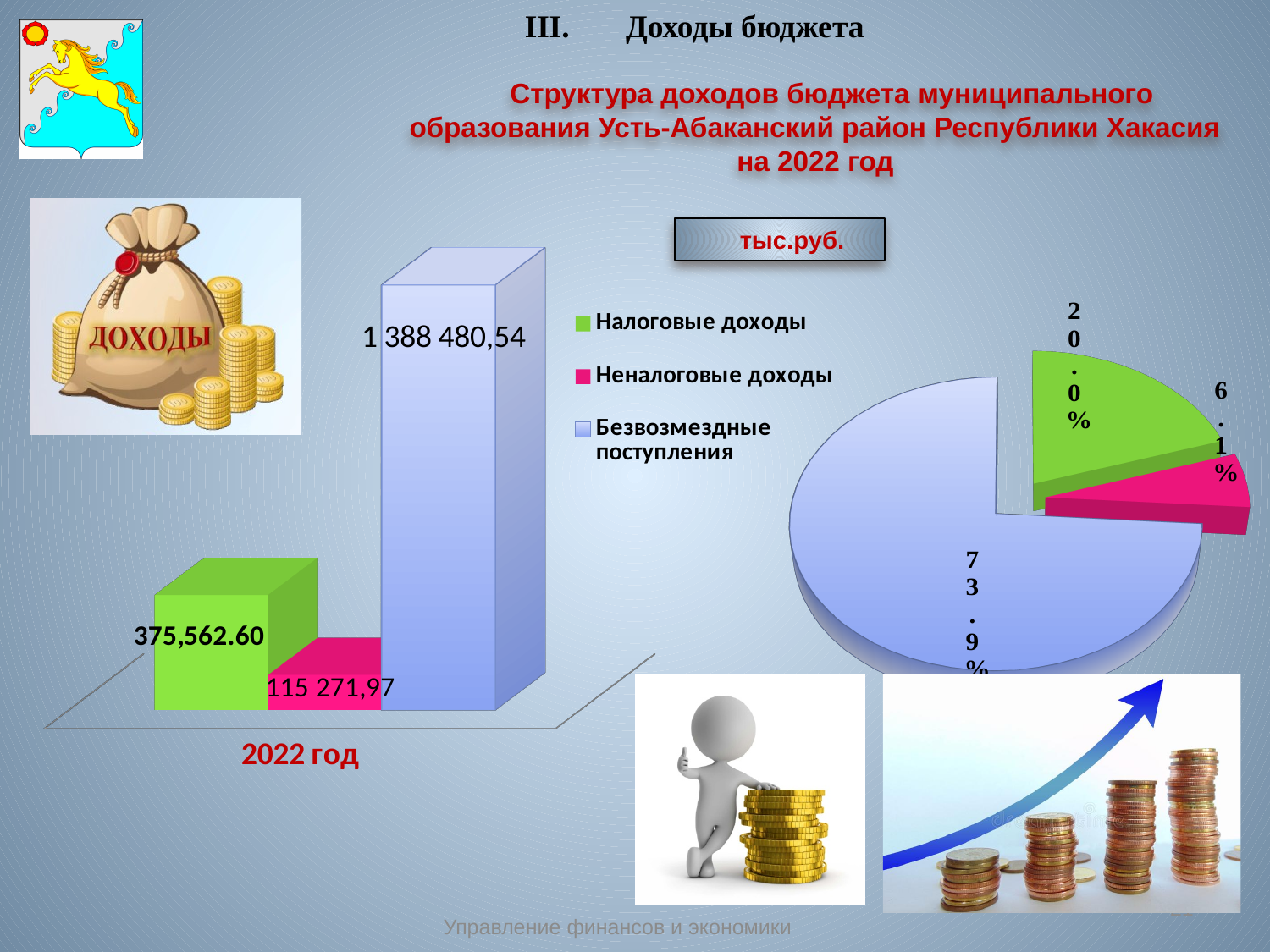
On the bar chart on the left, which is larger: Налоговые доходы or Неналоговые доходы? Налоговые доходы On the pie chart on the right, what share does the green slice (Налоговые доходы) have? 20.0% On the pie chart on the right, what share does the pink slice (Неналоговые доходы) have? 6.1% On the bar chart on the left, what is the value for Безвозмездные поступления? 1 388 480,54 On the bar chart on the left, what is the value for Налоговые доходы? 375,562.60 On the bar chart on the left, which series has the highest value? Безвозмездные поступления On the bar chart on the left, what is the value for Неналоговые доходы? 115 271,97 What kind of chart is the chart on the right of the slide? Pie chart On the bar chart on the left, which series has the lowest value? Неналоговые доходы What kind of chart is the chart on the left of the slide? Bar chart How many series does the legend of the bar chart on the left list? 3 On the pie chart on the right, what share does the largest slice (Безвозмездные поступления) have? 73.9%